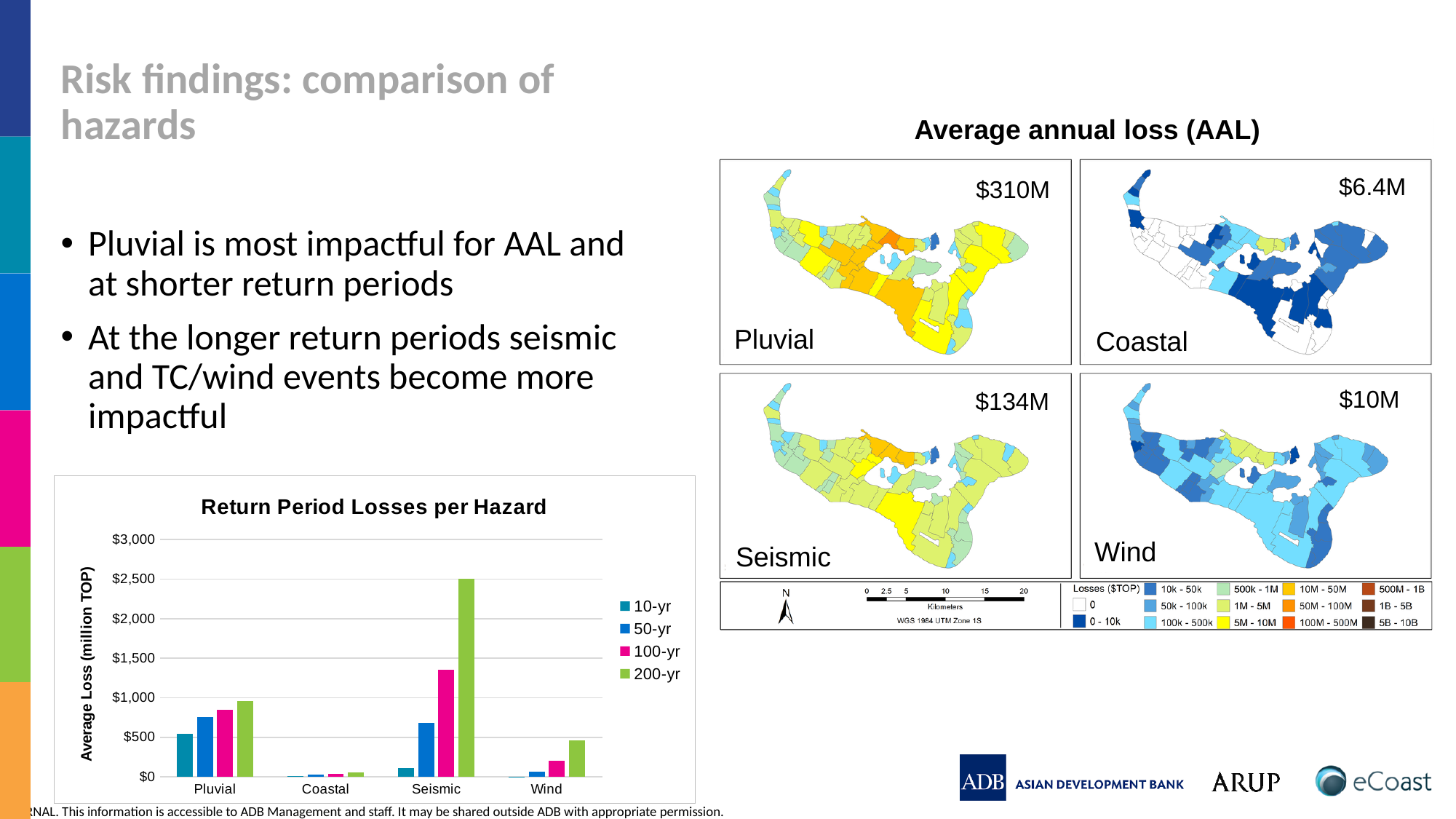
In the "Return Period Losses per Hazard" chart, which hazard has the highest 10-yr loss? Pluvial In the "Return Period Losses per Hazard" chart, which hazard has the lowest 200-yr loss? Coastal How many series does the legend of the "Return Period Losses per Hazard" chart list? 4 In the "Return Period Losses per Hazard" chart, is the 200-yr loss for Pluvial greater or less than $1,000? less In the "Return Period Losses per Hazard" chart, which hazard has the highest 200-yr loss? Seismic In the "Return Period Losses per Hazard" chart, is the 200-yr loss for Seismic greater or less than $2,000? greater How many hazard categories are shown on the x axis of the "Return Period Losses per Hazard" chart? 4 In the "Return Period Losses per Hazard" chart, is the 100-yr loss for Seismic greater or less than $1,000? greater In the "Return Period Losses per Hazard" chart, do the Pluvial losses rise or fall as the return period increases from 10-yr to 200-yr? rise What type of chart is "Return Period Losses per Hazard"? bar chart In the "Return Period Losses per Hazard" chart, is the 100-yr loss larger for Pluvial or for Seismic? Seismic What is the y-axis title of the "Return Period Losses per Hazard" chart? Average Loss (million TOP)